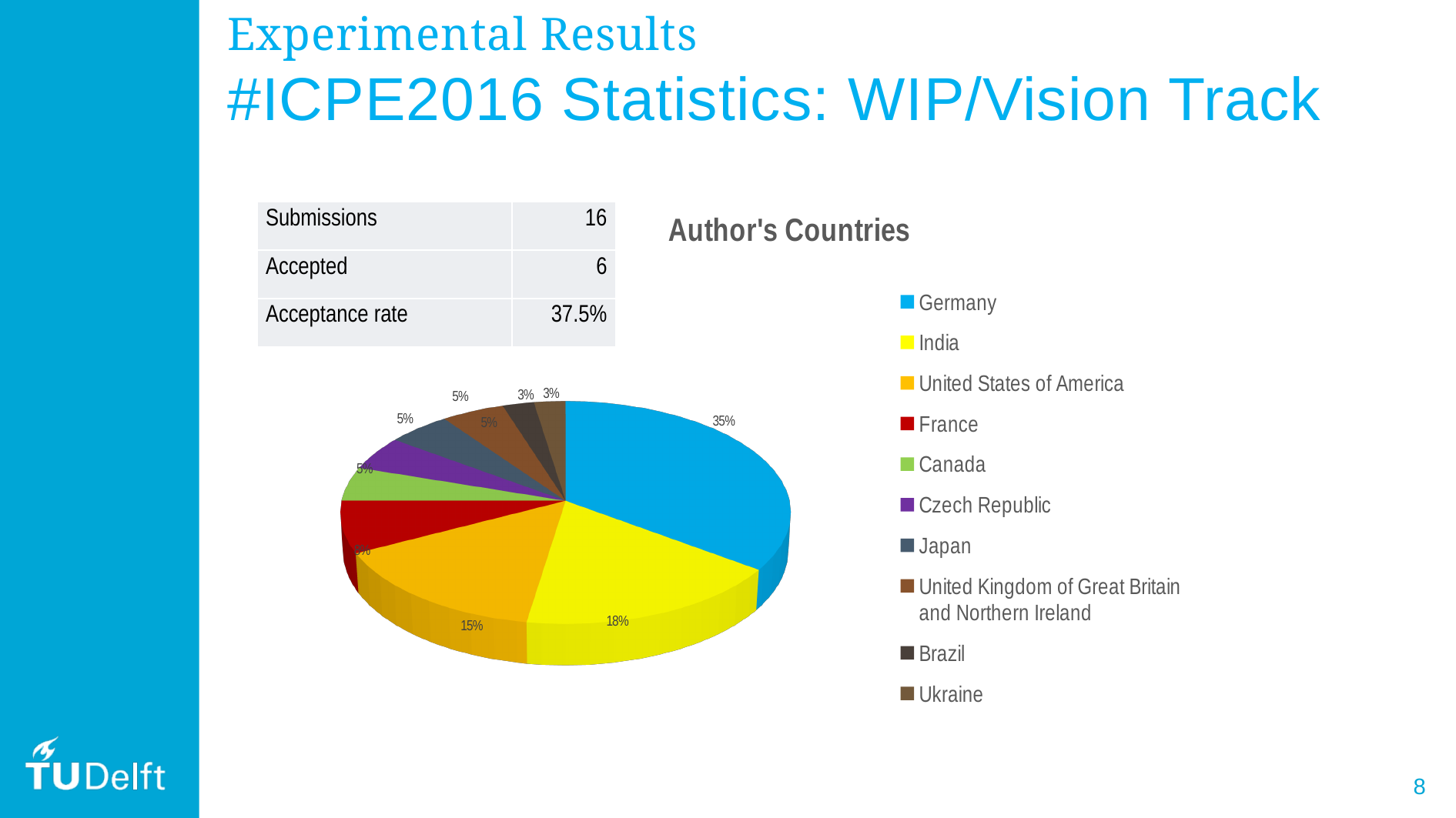
What is the difference between the India slice and the United States of America slice? 3% What share of the pie does Germany take? 35% What is the value for Brazil? 3% What is the value for India? 18% Which country has the largest slice of the pie? Germany What is the difference between the Germany slice and the India slice? 17% How many countries are listed in the legend? 10 What kind of chart is shown on the slide? pie chart What is the title of the chart? Author's Countries What is the value for Japan? 5% Which is larger, the slice for Germany or the slice for India? Germany What is the value for United States of America? 15%